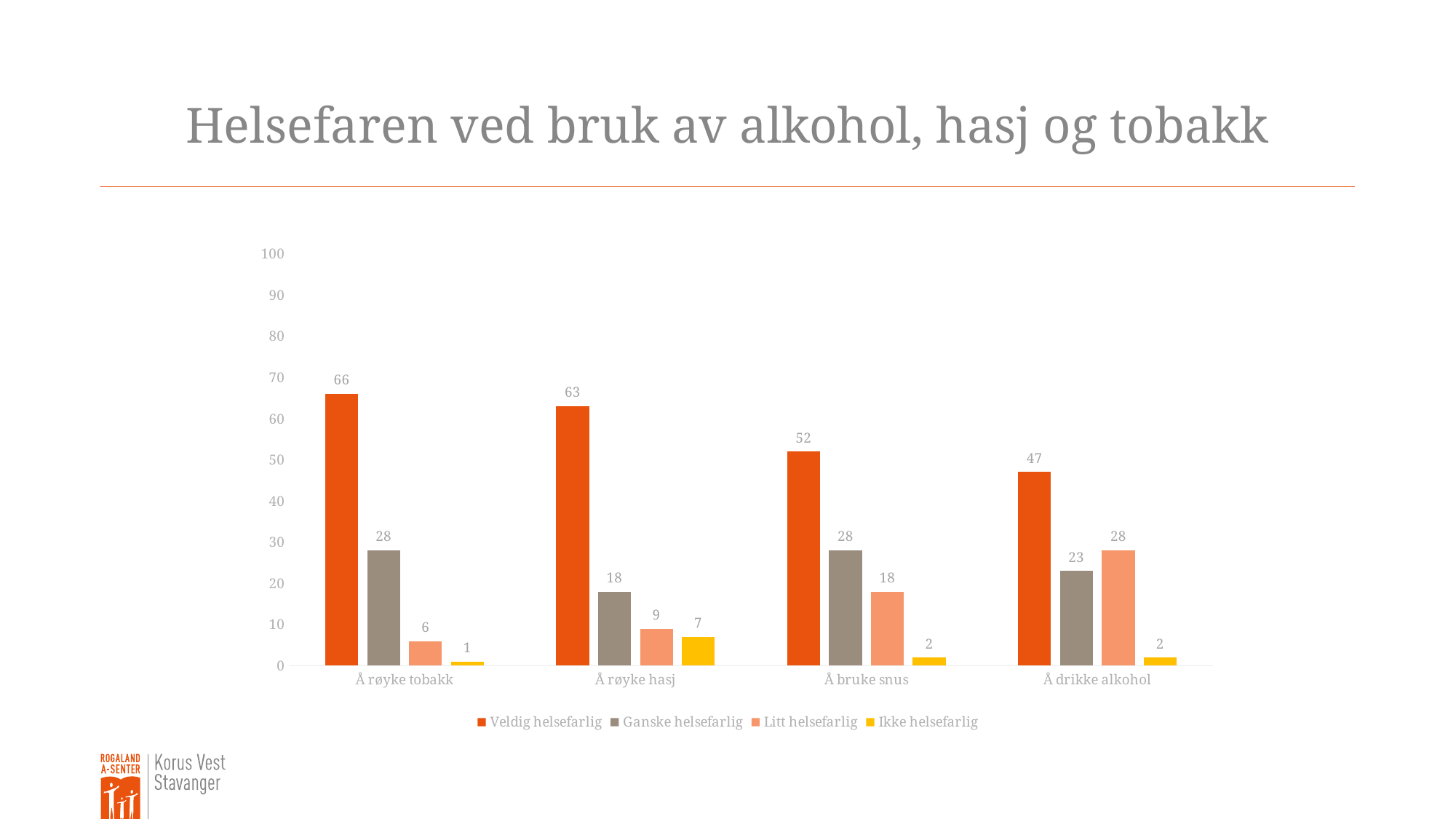
What is the difference between the "Veldig helsefarlig" values for "Å røyke tobakk" and "Å drikke alkohol"? 19 What kind of chart is shown on the slide? Bar chart What is the value for "Ikke helsefarlig" for "Å røyke hasj"? 7 Which category has the highest value for "Veldig helsefarlig"? Å røyke tobakk Which category has the lowest value for "Ikke helsefarlig"? Å røyke tobakk What is the value for "Veldig helsefarlig" for "Å røyke tobakk"? 66 Is the value for "Veldig helsefarlig" for "Å bruke snus" greater or less than 50? greater Which is larger: "Ganske helsefarlig" for "Å bruke snus" or "Ganske helsefarlig" for "Å røyke hasj"? Å bruke snus What is the value for "Litt helsefarlig" for "Å drikke alkohol"? 28 How many series does the legend list? 4 How many categories are shown on the x axis? 4 What is the title of the chart? Helsefaren ved bruk av alkohol, hasj og tobakk